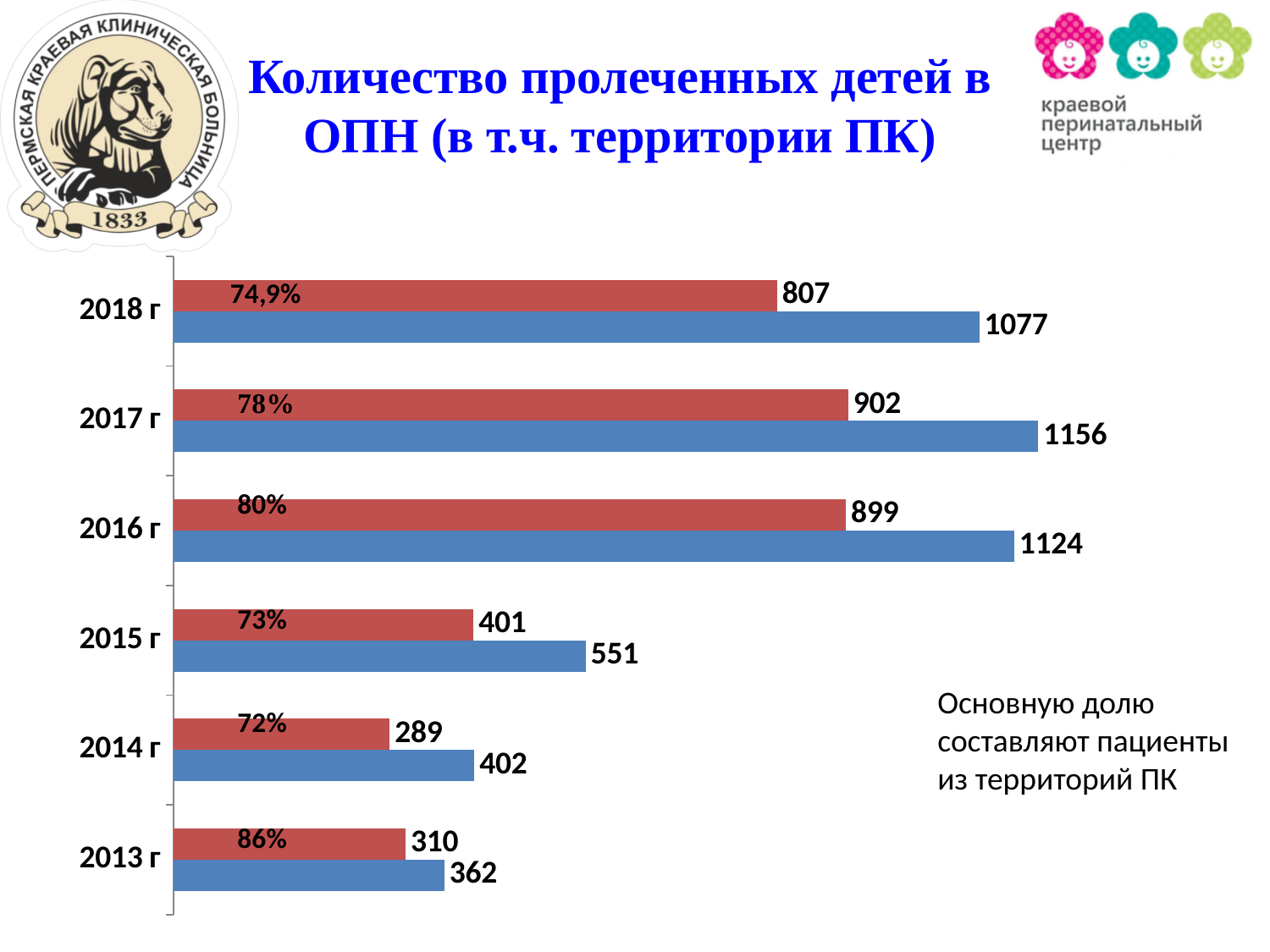
What is the value of the red bar for 2017 г? 902 What percentage is printed on the red bar for 2013 г? 86% What is the value of the blue bar for 2018 г? 1077 Which year has the lowest blue bar? 2013 г What is the difference between the blue bar for 2017 г and the blue bar for 2018 г? 79 How many years are shown on the chart? 6 What is the value of the red bar for 2015 г? 401 Which year has the highest blue bar? 2017 г Do the blue bar values rise or fall from 2013 г to 2017 г? Rise What kind of chart is shown on the slide? Bar chart Which is larger: the blue bar for 2016 г or the blue bar for 2018 г? 2016 г What is the difference between the blue bar and the red bar for 2017 г? 254